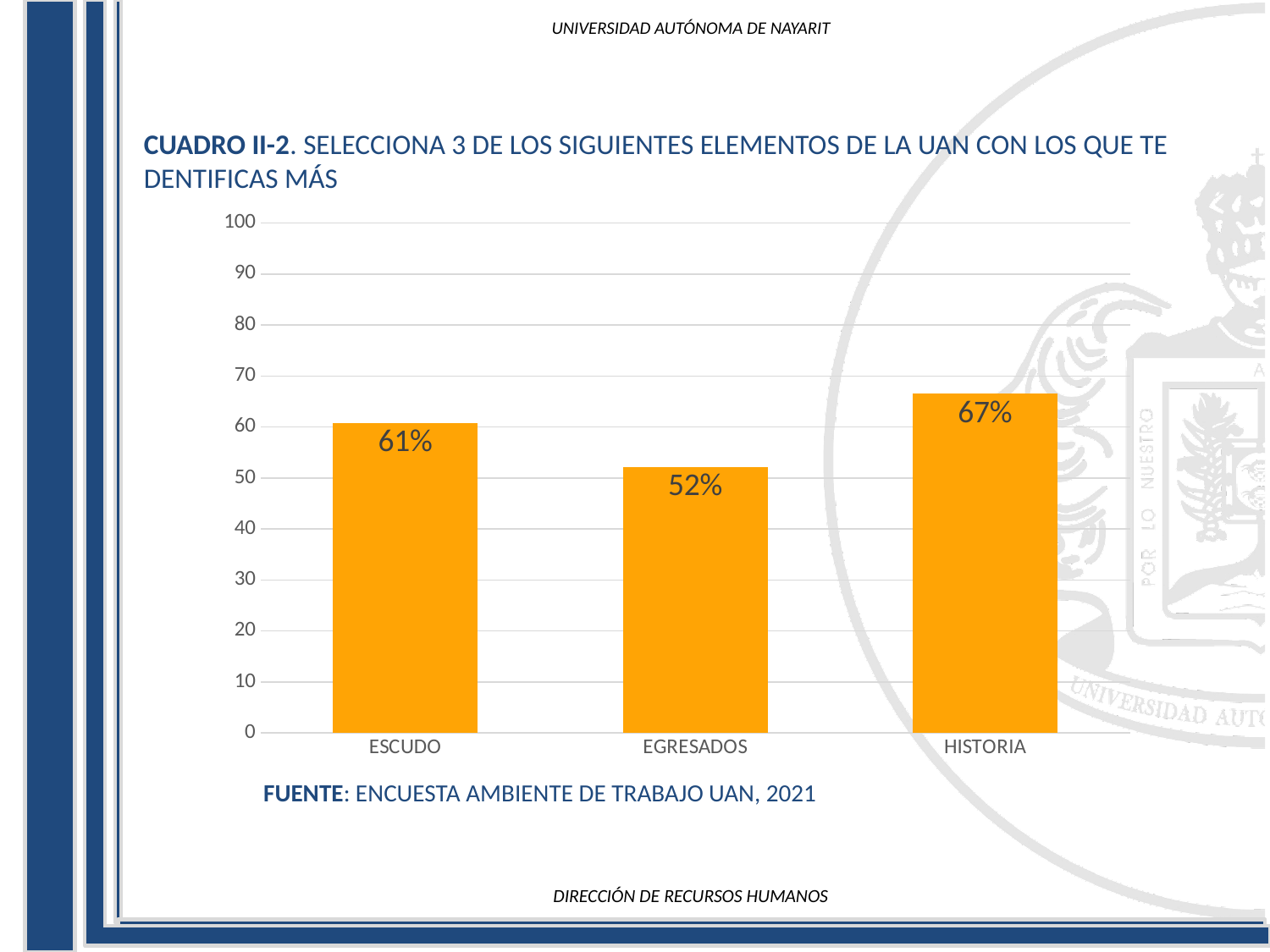
What kind of chart is shown on the slide? bar chart What is the value for HISTORIA? 67% What is the value for EGRESADOS? 52% Which is larger, the value for ESCUDO or the value for HISTORIA? HISTORIA What is the value for ESCUDO? 61% What is the difference between the values for HISTORIA and EGRESADOS? 15% Is the value for EGRESADOS greater or less than 60? less What source is cited below the chart? ENCUESTA AMBIENTE DE TRABAJO UAN, 2021 What is the difference between the values for ESCUDO and EGRESADOS? 9% How many categories are shown on the x axis? 3 Which category has the highest value? HISTORIA Which category has the lowest value? EGRESADOS